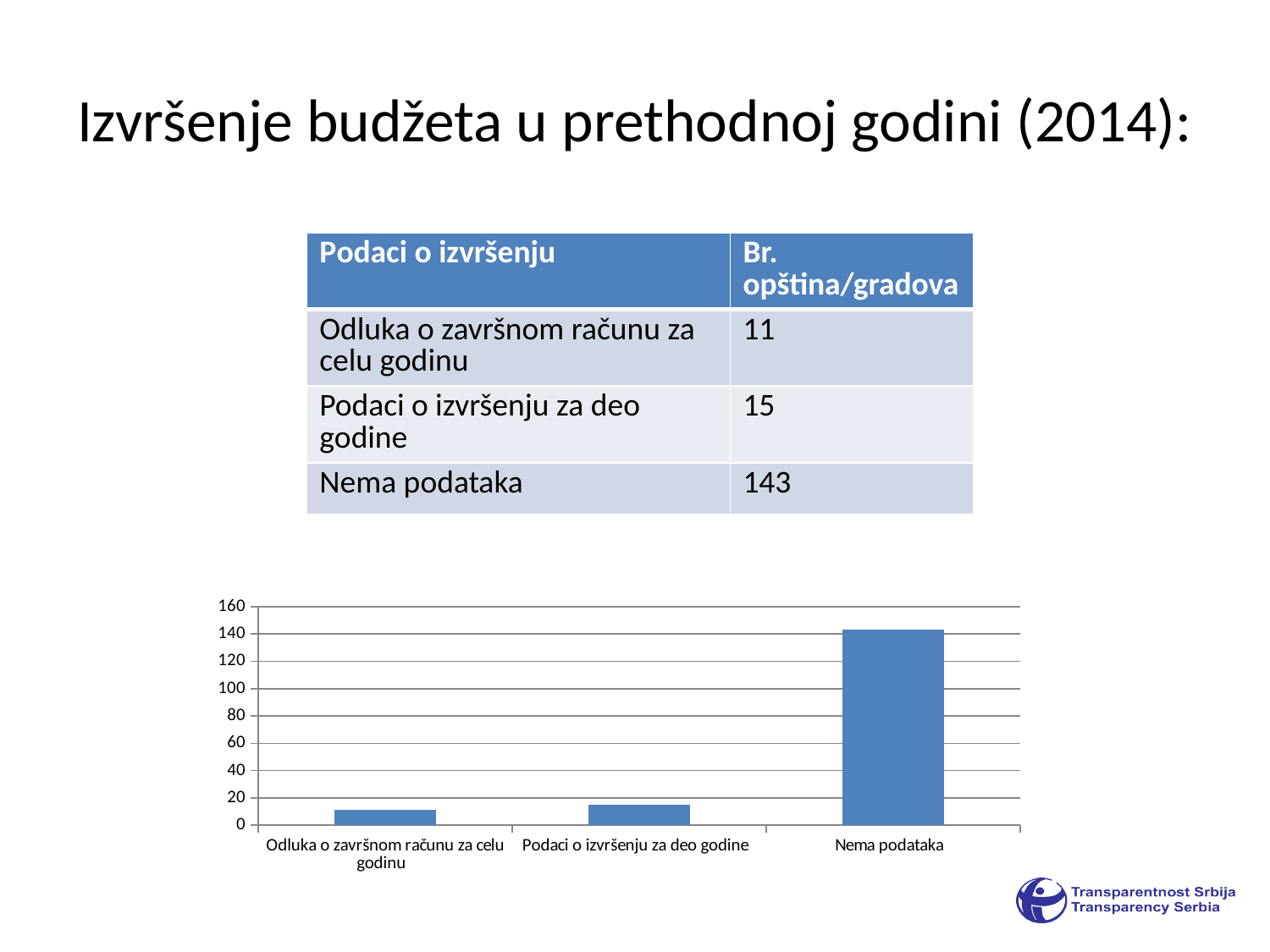
What kind of chart is shown on the slide? bar chart Which is larger, the value for Podaci o izvršenju za deo godine or the value for Odluka o završnom računu za celu godinu? Podaci o izvršenju za deo godine Is the value for Podaci o izvršenju za deo godine greater or less than 20? less What is the highest value shown on the vertical axis of the chart? 160 Is the value for Nema podataka greater or less than 140? greater What is the difference between the values for Nema podataka and Podaci o izvršenju za deo godine? 128 Which category has the highest bar in the chart? Nema podataka What is the value for Nema podataka? 143 What is the value for Odluka o završnom računu za celu godinu? 11 Which category has the lowest bar in the chart? Odluka o završnom računu za celu godinu How many categories does the bar chart show? 3 What is the value for Podaci o izvršenju za deo godine? 15